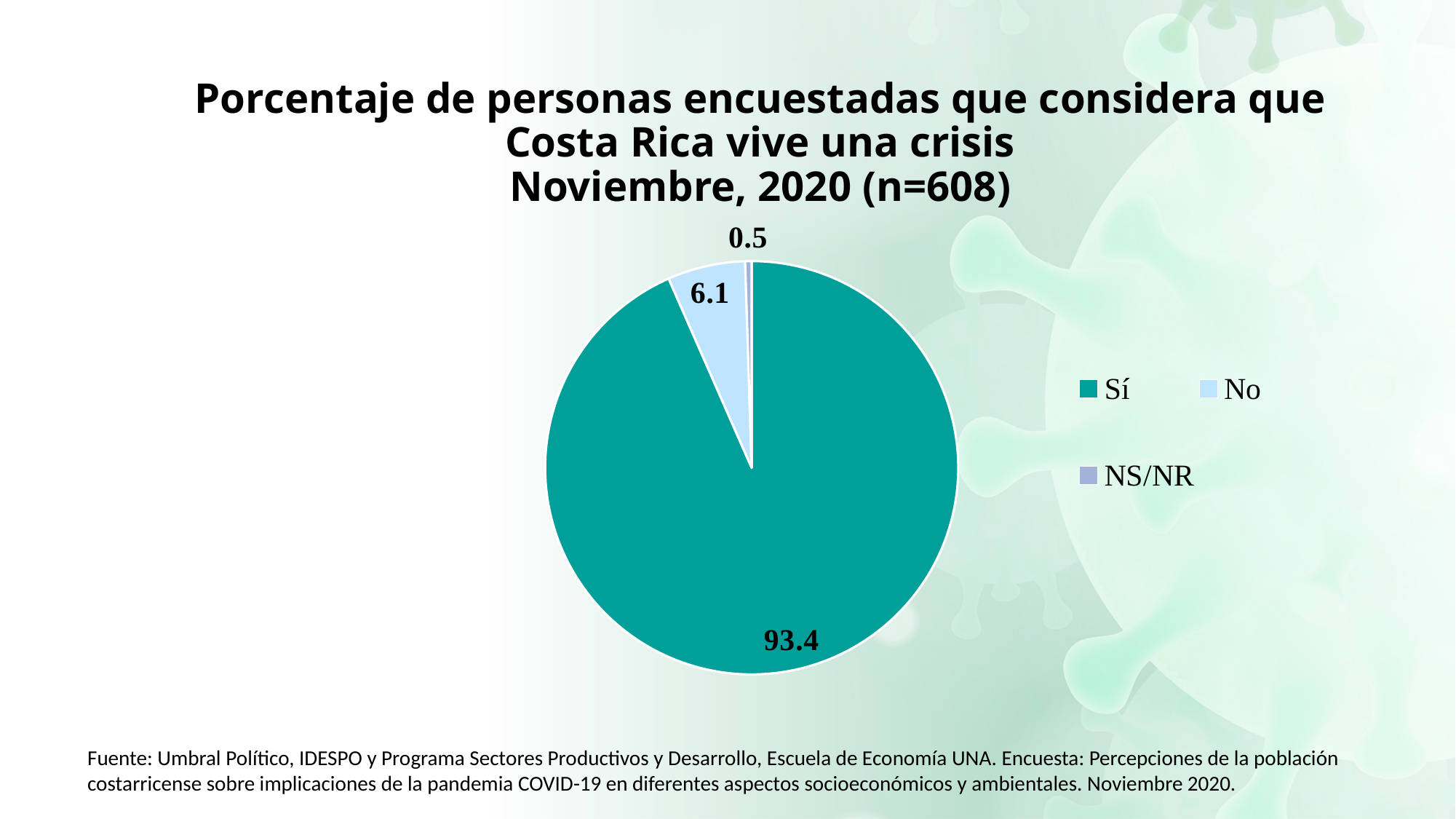
Which legend entry is shown in light blue? No What is the difference between the values for No and NS/NR? 5.6 What is the value for No? 6.1 What is the value for NS/NR? 0.5 What is the difference between the values for Sí and No? 87.3 What is the value for Sí? 93.4 What kind of chart is shown on the slide? Pie chart What is the sample size (n) stated in the chart title? 608 Which category has the smallest slice? NS/NR Which is larger, the value for No or the value for NS/NR? No How many categories does the pie chart show? 3 Which category has the largest slice? Sí